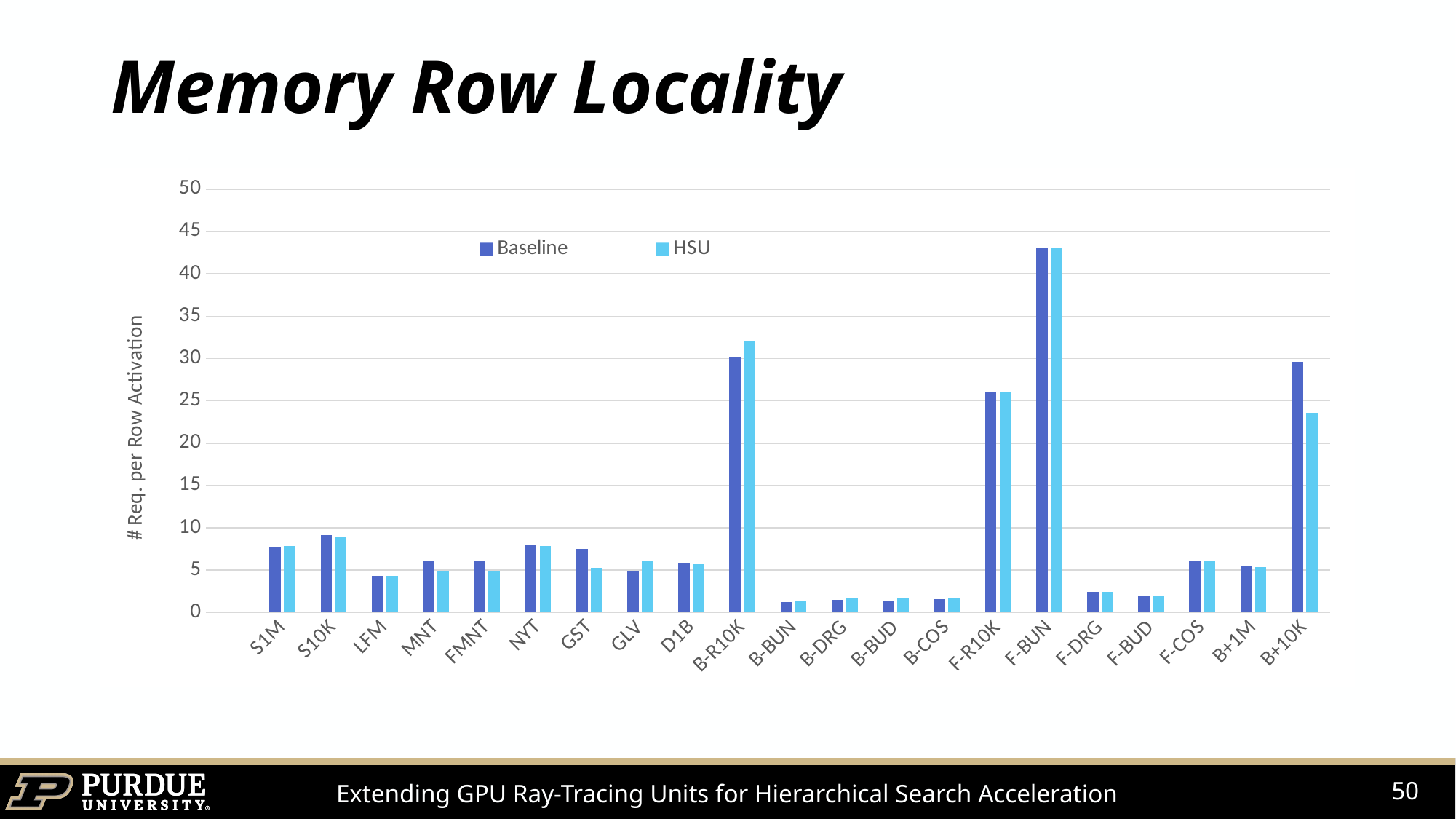
For B+10K, which series has the larger value, Baseline or HSU? Baseline What kind of chart is shown on the slide? bar chart How many categories are shown along the x axis? 21 How many series does the legend list? 2 Is the Baseline value for LFM greater or less than 5? less Which category has the highest Baseline value? F-BUN Is the HSU value for B-R10K greater or less than 30? greater What is the label of the y axis? # Req. per Row Activation Is the Baseline value for F-BUN greater or less than 40? greater Which category has the highest HSU value? F-BUN For GST, which series has the larger value, Baseline or HSU? Baseline